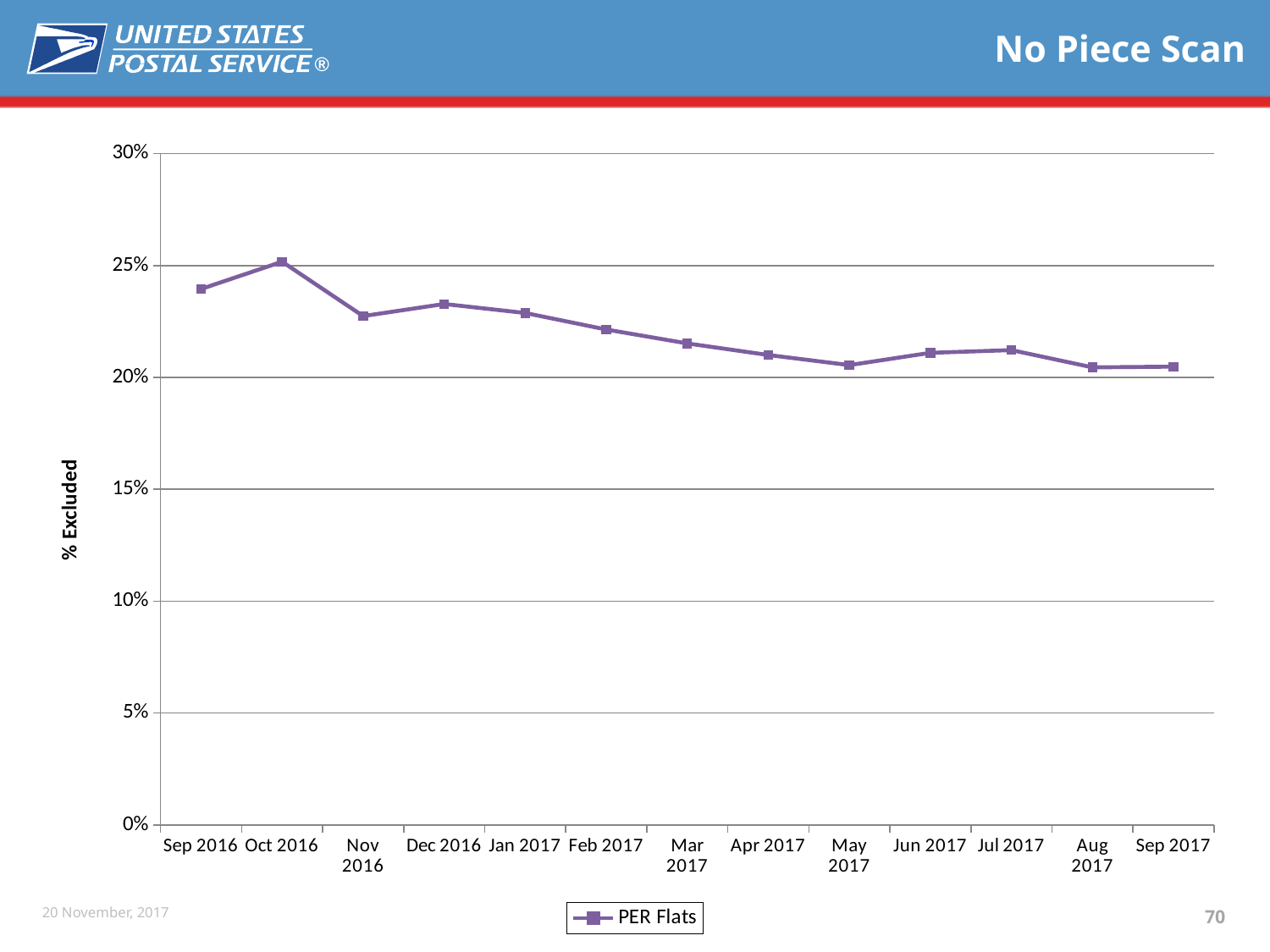
Is the value for Nov 2016 greater or less than 25%? less How many months are plotted along the x axis? 13 Which is larger, the value for Oct 2016 or the value for Nov 2016? Oct 2016 What is the label on the vertical axis? % Excluded Overall, do the PER Flats values rise or fall from Sep 2016 to Sep 2017? fall Which is larger, the value for Sep 2016 or the value for Sep 2017? Sep 2016 How many series does the legend list? 1 Is the value for Sep 2017 greater or less than 15%? greater In which month is the PER Flats value highest? Oct 2016 Is the value for Sep 2016 greater or less than 20%? greater What is the name of the series shown in the legend? PER Flats What kind of chart is shown on the slide? line chart